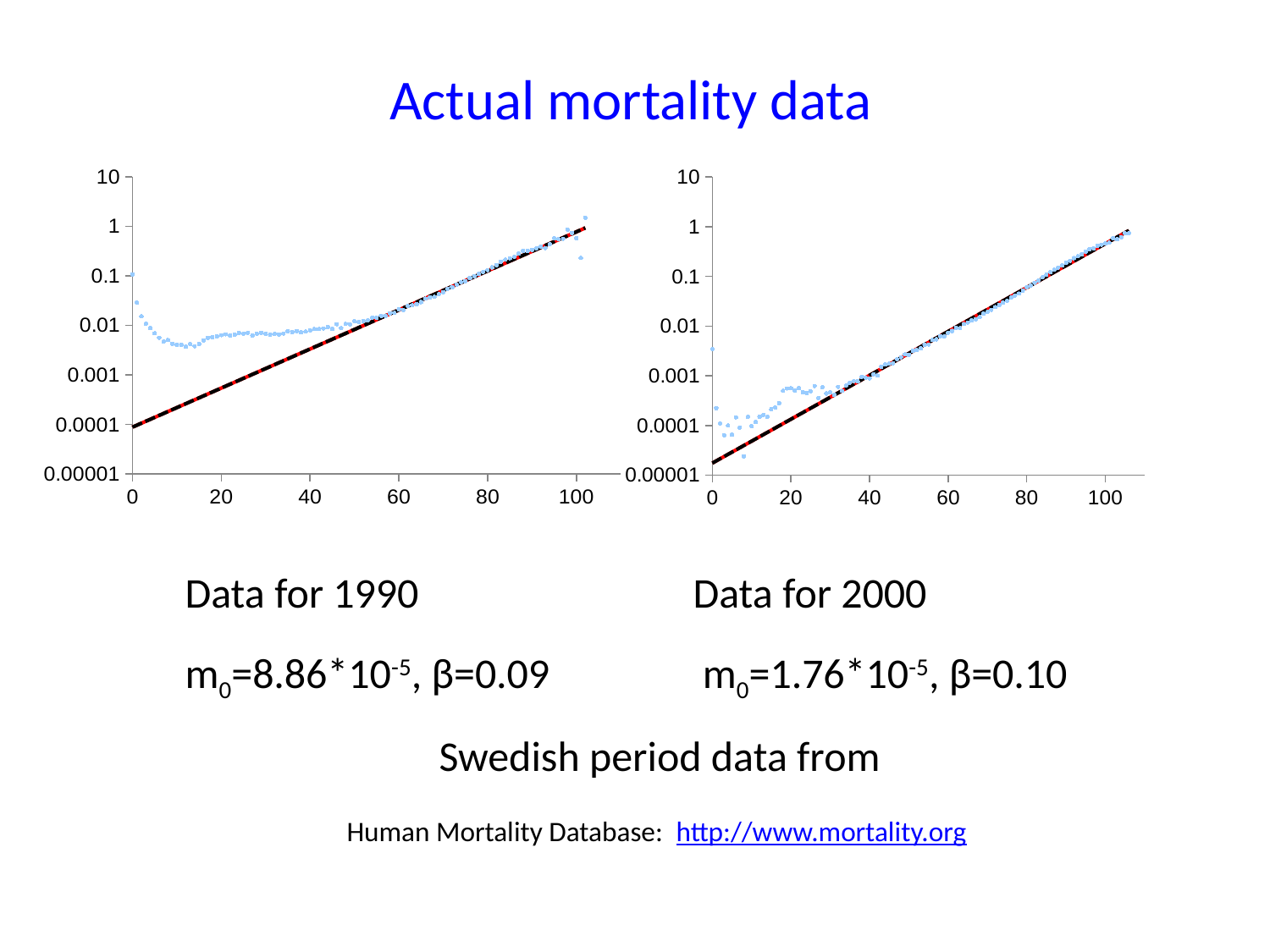
In the left chart (Data for 1990), do the plotted values generally rise or fall as the x axis increases from 20 to 100? rise In the left chart (Data for 1990), is the plotted value at x = 0 greater or less than 0.01? greater In the right chart (Data for 2000), is the plotted value at x = 0 greater or less than 0.001? greater What is the lowest tick value shown on the y axis of the right chart (Data for 2000)? 0.00001 What is the highest tick value shown on the y axis of the left chart (Data for 1990)? 10 In the left chart (Data for 1990), is the plotted value at x = 20 greater or less than 0.01? less What kind of chart is the left chart (Data for 1990)? scatter chart In the right chart (Data for 2000), do the plotted values generally rise or fall along the x axis? rise Which chart has the larger plotted value at x = 0, the left chart (Data for 1990) or the right chart (Data for 2000)? the left chart (Data for 1990) How many charts are shown on the slide? 2